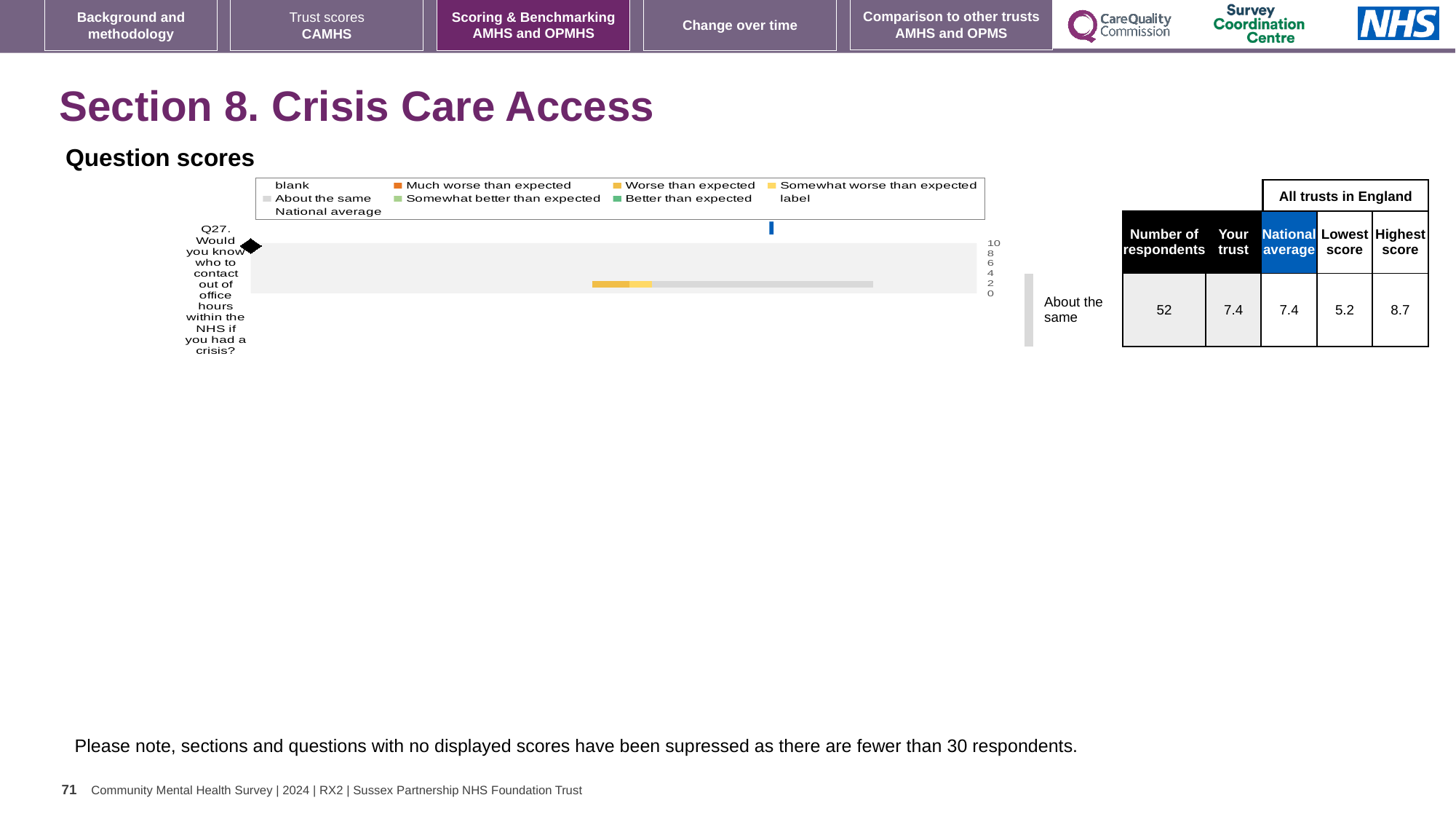
In the table beside the chart, what is the number of respondents for Q27? 52 What kind of chart is shown under 'Question scores'? bar chart In the table beside the chart, what is the difference between the highest score and the lowest score for Q27? 3.5 In the table beside the chart, is the 'Your trust' score for Q27 larger than the lowest score? Yes In the table beside the chart, what is the 'Your trust' score for Q27? 7.4 In the table beside the chart, what is the highest score among all trusts in England for Q27? 8.7 In the table beside the chart, what is the lowest score among all trusts in England for Q27? 5.2 Which question number is plotted in the Question scores chart? Q27 What benchmark category is shown for Q27 next to the chart? About the same In the table beside the chart, what is the national average score for Q27? 7.4 How many questions are plotted in the Question scores chart? 1 What is the title of the chart on the slide? Question scores